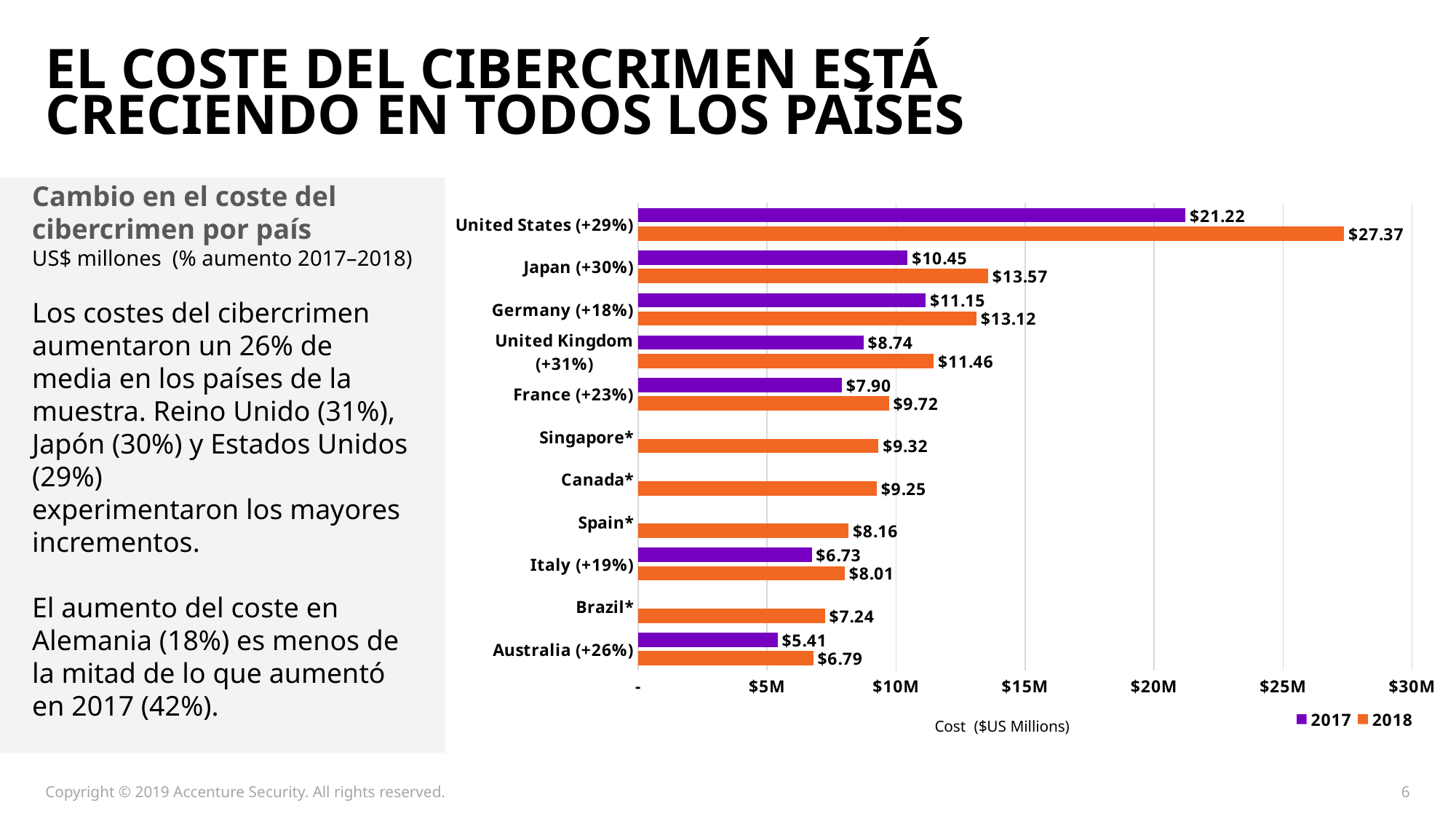
What is the 2017 value for Japan (+30%)? $10.45 How many series does the legend list? 2 What kind of chart is shown on the slide? bar chart Is the 2017 value for United States (+29%) greater or less than $20M? greater What colour represents the 2018 series in the legend? orange What is the difference between the 2018 and 2017 values for Germany (+18%)? $1.97 Which country has the lowest 2017 value? Australia (+26%) What is the 2018 value for United States (+29%)? $27.37 What is the 2018 value for Singapore*? $9.32 How many countries are shown on the chart? 11 Which country has the highest 2018 value? United States (+29%) Which is larger, the 2018 value for France (+23%) or the 2018 value for Canada*? France (+23%)